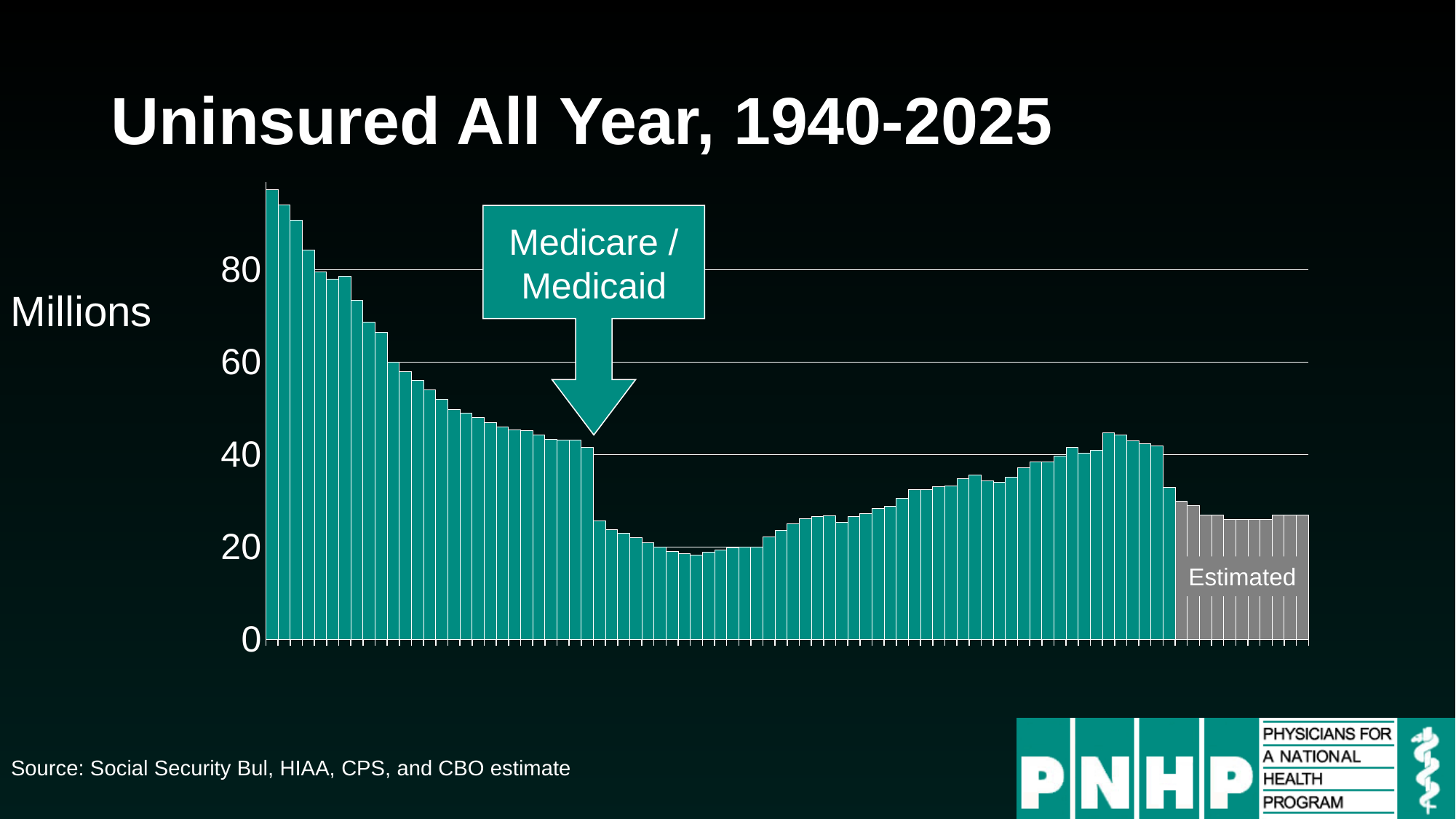
Which bar is the highest in the chart, the leftmost bar or the rightmost bar? the leftmost bar What unit is the vertical axis of the chart measured in? Millions What is the title of the chart? Uninsured All Year, 1940-2025 What do the grey bars at the right end of the chart represent? Estimated Do the values rise or fall from the leftmost bar up to the Medicare / Medicaid arrow? fall Is the value of the leftmost bar greater or less than 80? greater Are the grey 'Estimated' bars greater or less than 20? greater Is the value of the rightmost bar greater or less than 40? less Which is larger: the bar just before the Medicare / Medicaid arrow or the bar just after it? the bar just before it What kind of chart is shown on the slide? bar chart